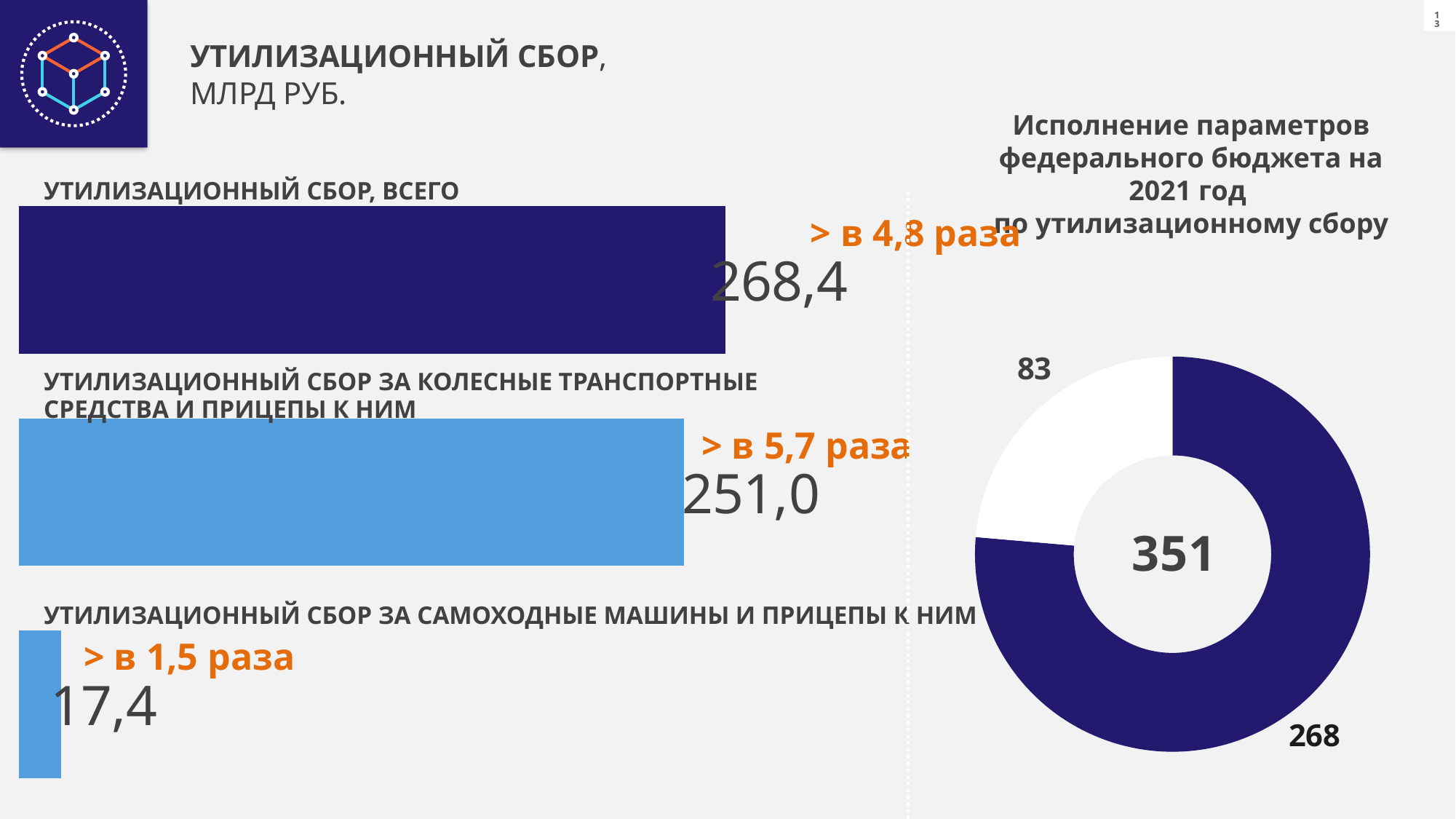
In the donut chart on the right, what is the value of the white segment? 83 In the donut chart on the right, what total is printed in the centre? 351 In the bar chart on the left, which is larger: the value for колесные транспортные средства or the value for самоходные машины? Колесные транспортные средства What kind of chart is shown on the left side of the slide? Bar chart In the bar chart on the left, what is the value for 'Утилизационный сбор за колесные транспортные средства и прицепы к ним'? 251,0 In the bar chart on the left, what is the value for 'Утилизационный сбор за самоходные машины и прицепы к ним'? 17,4 How many bars are shown in the bar chart on the left? 3 In the donut chart 'Исполнение параметров федерального бюджета на 2021 год по утилизационному сбору', what is the value of the dark blue segment? 268 In the bar chart 'УТИЛИЗАЦИОННЫЙ СБОР, МЛРД РУБ.', what is the value for 'Утилизационный сбор, всего'? 268,4 In the bar chart on the left, which category has the lowest value? Утилизационный сбор за самоходные машины и прицепы к ним In the bar chart on the left, which category has the highest value? Утилизационный сбор, всего In the bar chart on the left, what is the difference between the value for колесные транспортные средства (251,0) and the value for самоходные машины (17,4)? 233,6